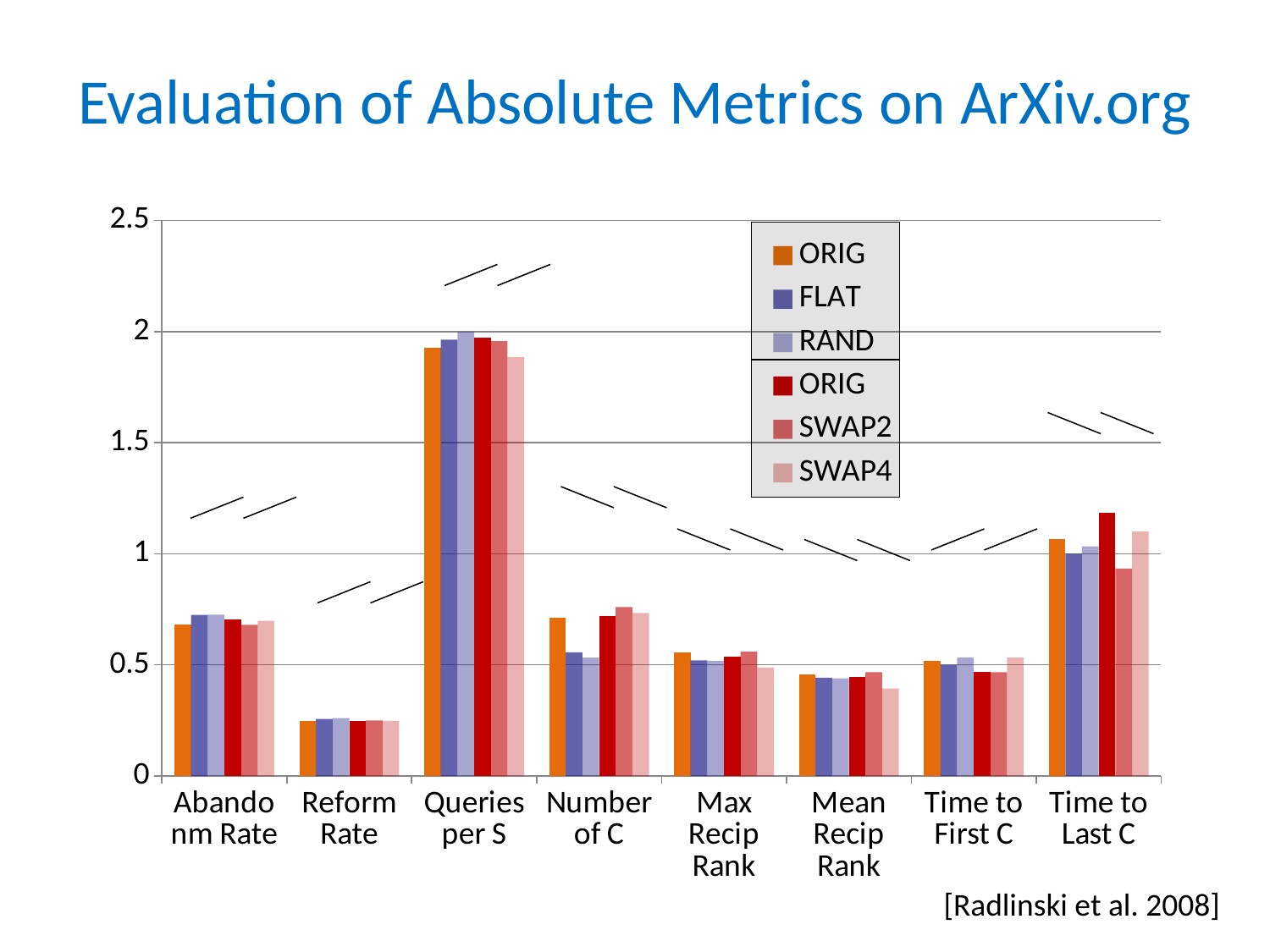
What is the title of the slide? Evaluation of Absolute Metrics on ArXiv.org Which category has the lowest bars overall? Reform Rate Is the value for the FLAT series in Reform Rate greater or less than 0.5? less Is the value for the red ORIG series in Time to Last C greater or less than 1? greater How many series does the legend list? 6 In Time to Last C, which is larger: the red ORIG bar or the SWAP2 bar? red ORIG Is the value for the orange ORIG series in Queries per S greater or less than 1.5? greater In Number of C, which is larger: the orange ORIG bar or the FLAT bar? orange ORIG How many categories are shown along the x axis? 8 Which category has the highest bars overall? Queries per S What kind of chart is shown on the slide? bar chart